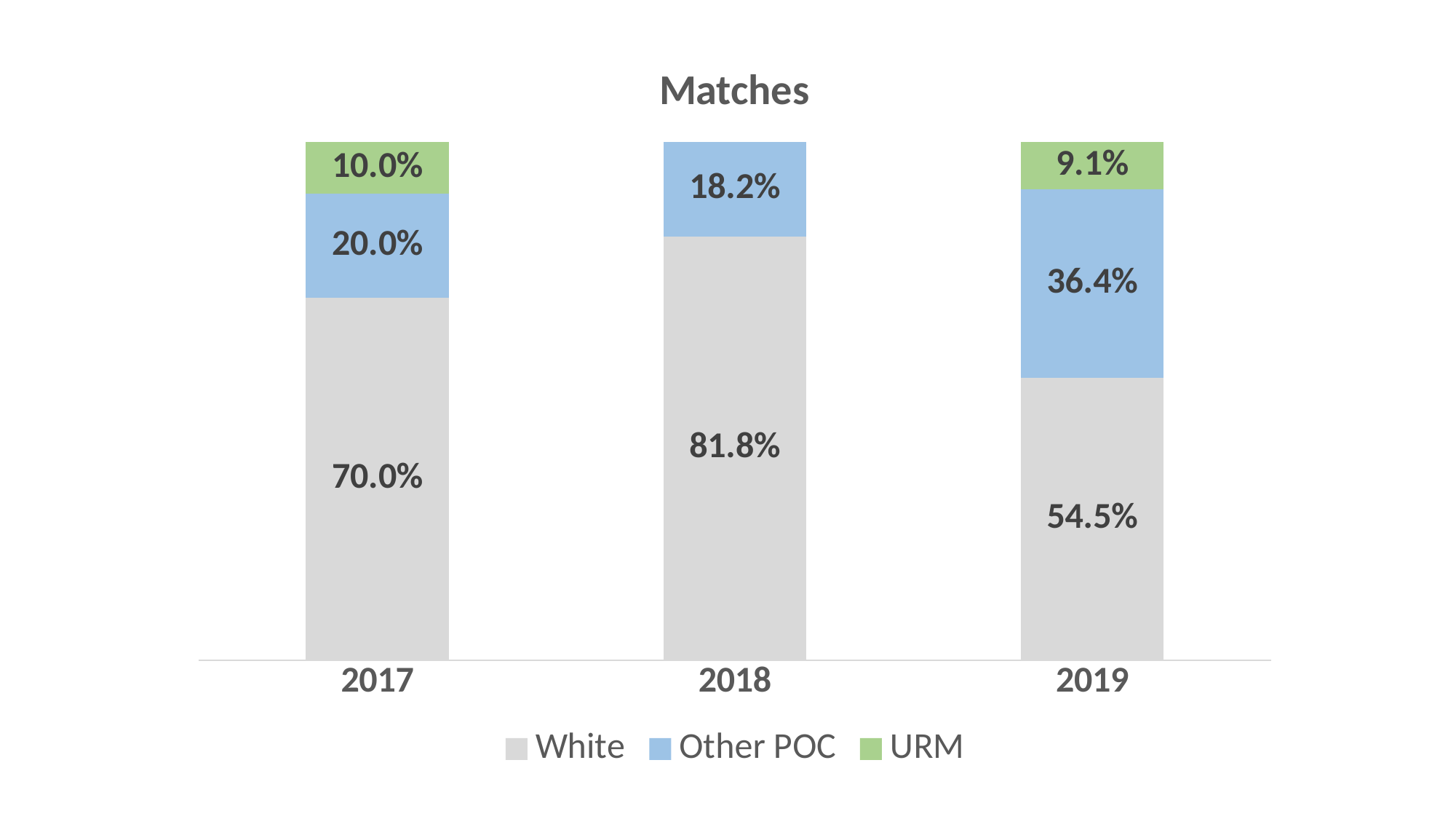
Which year has the highest White share of matches? 2018 Is the Other POC share larger in 2018 or in 2019? 2019 What is the Other POC share of matches in 2019? 36.4% What kind of chart is shown? Stacked bar chart Which year has the lowest White share of matches? 2019 What is the URM share of matches in 2019? 9.1% What is the title of the chart? Matches What is the difference between the Other POC share in 2019 and in 2017? 16.4% How many series does the legend list? 3 How many years are shown on the x axis? 3 What is the White share of matches in 2017? 70.0% What is the White share of matches in 2018? 81.8%